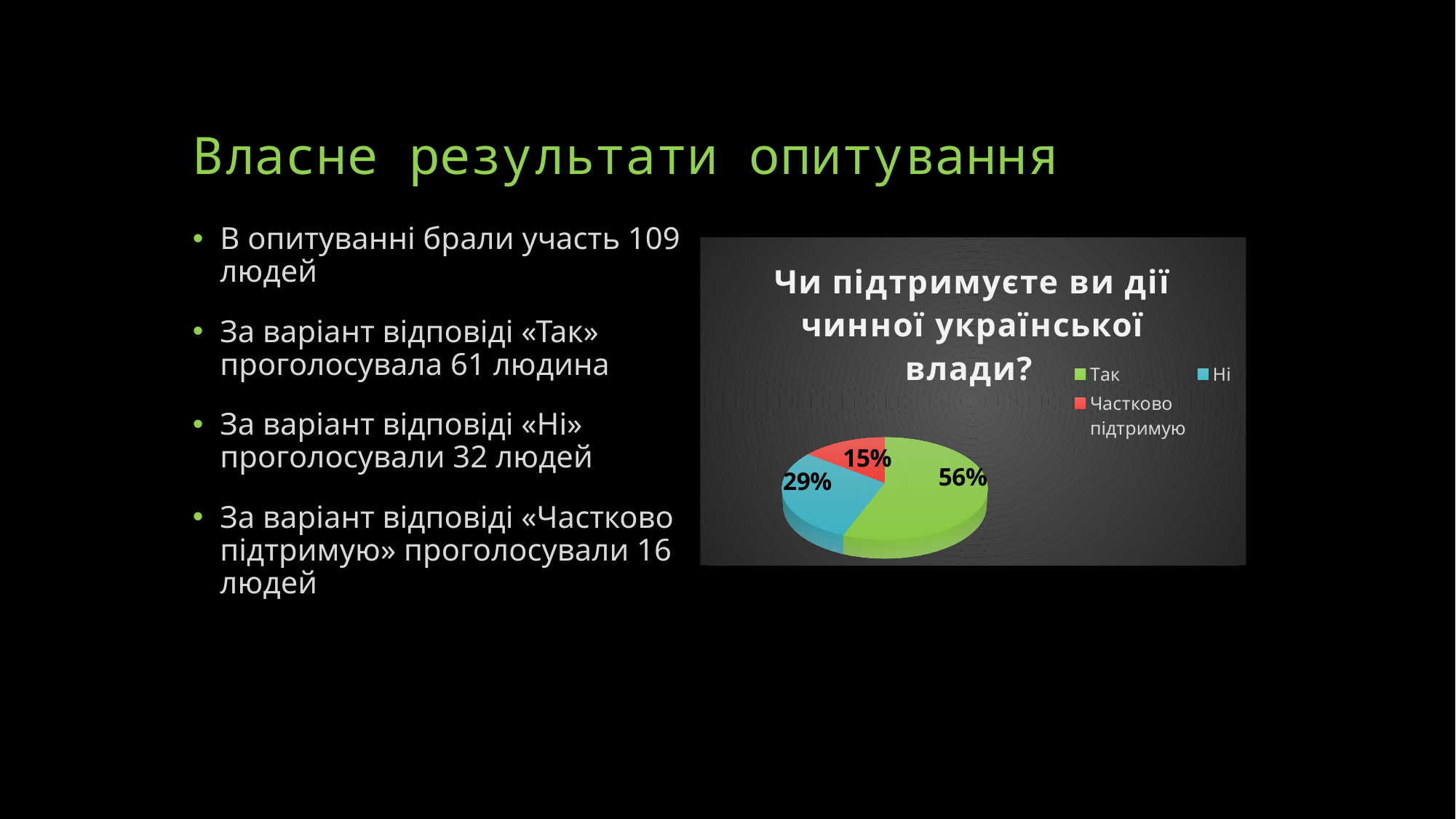
Which slice of the pie is the largest? Так Which slice of the pie is the smallest? Частково підтримую What share of the pie does the "Ні" slice represent? 29% What colour is the "Ні" slice in the pie chart? blue What share of the pie does the "Частково підтримую" slice represent? 15% How many slices does the pie chart have? 3 What is the difference in percentage points between the "Так" and "Ні" slices? 27 What is the title of the pie chart? Чи підтримуєте ви дії чинної української влади? Which is larger, the "Ні" slice or the "Частково підтримую" slice? Ні What is the difference in percentage points between the "Ні" and "Частково підтримую" slices? 14 What share of the pie does the "Так" slice represent? 56% What kind of chart is shown on the slide? pie chart